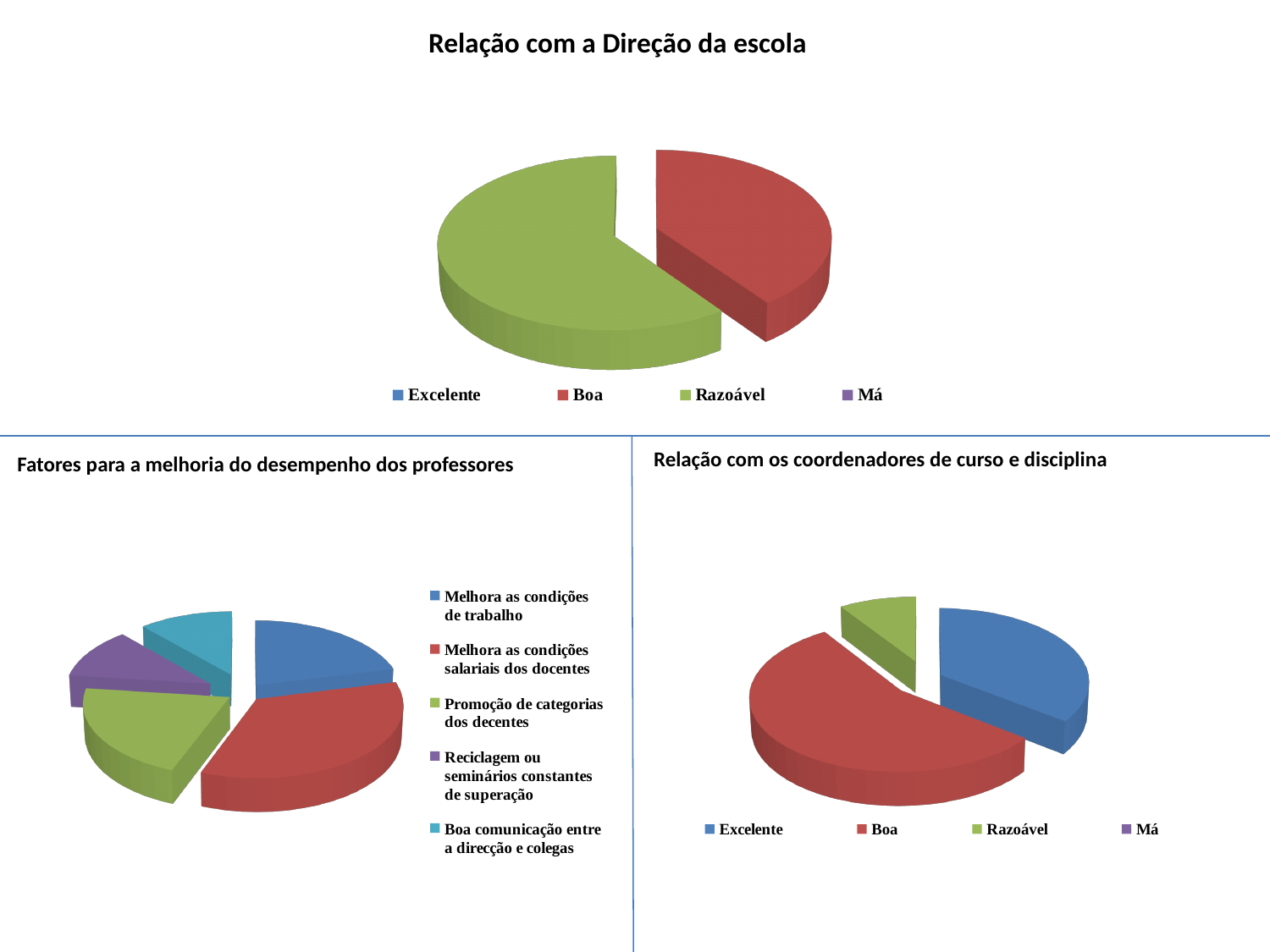
What is the title of the chart at the top of the slide? Relação com a Direção da escola What kind of chart is shown under the title 'Relação com os coordenadores de curso e disciplina'? pie chart In the 'Relação com os coordenadores de curso e disciplina' chart, which is larger, the slice for Excelente or the slice for Razoável? Excelente In the 'Relação com a Direção da escola' chart, which is larger, the slice for Boa or the slice for Razoável? Razoável In the 'Fatores para a melhoria do desempenho dos professores' chart, which category has the largest slice? Melhora as condições salariais dos docentes In the 'Relação com a Direção da escola' chart, which category has the largest slice? Razoável In the 'Fatores para a melhoria do desempenho dos professores' chart, which is larger, the slice for 'Melhora as condições de trabalho' or the slice for 'Melhora as condições salariais dos docentes'? Melhora as condições salariais dos docentes How many categories does the legend of the 'Relação com a Direção da escola' chart list? 4 How many categories does the legend of the 'Fatores para a melhoria do desempenho dos professores' chart list? 5 What kind of chart is shown under the title 'Relação com a Direção da escola'? pie chart In the 'Relação com os coordenadores de curso e disciplina' chart, which category has the largest slice? Boa In the 'Relação com a Direção da escola' chart, what colour is the slice for Boa? red